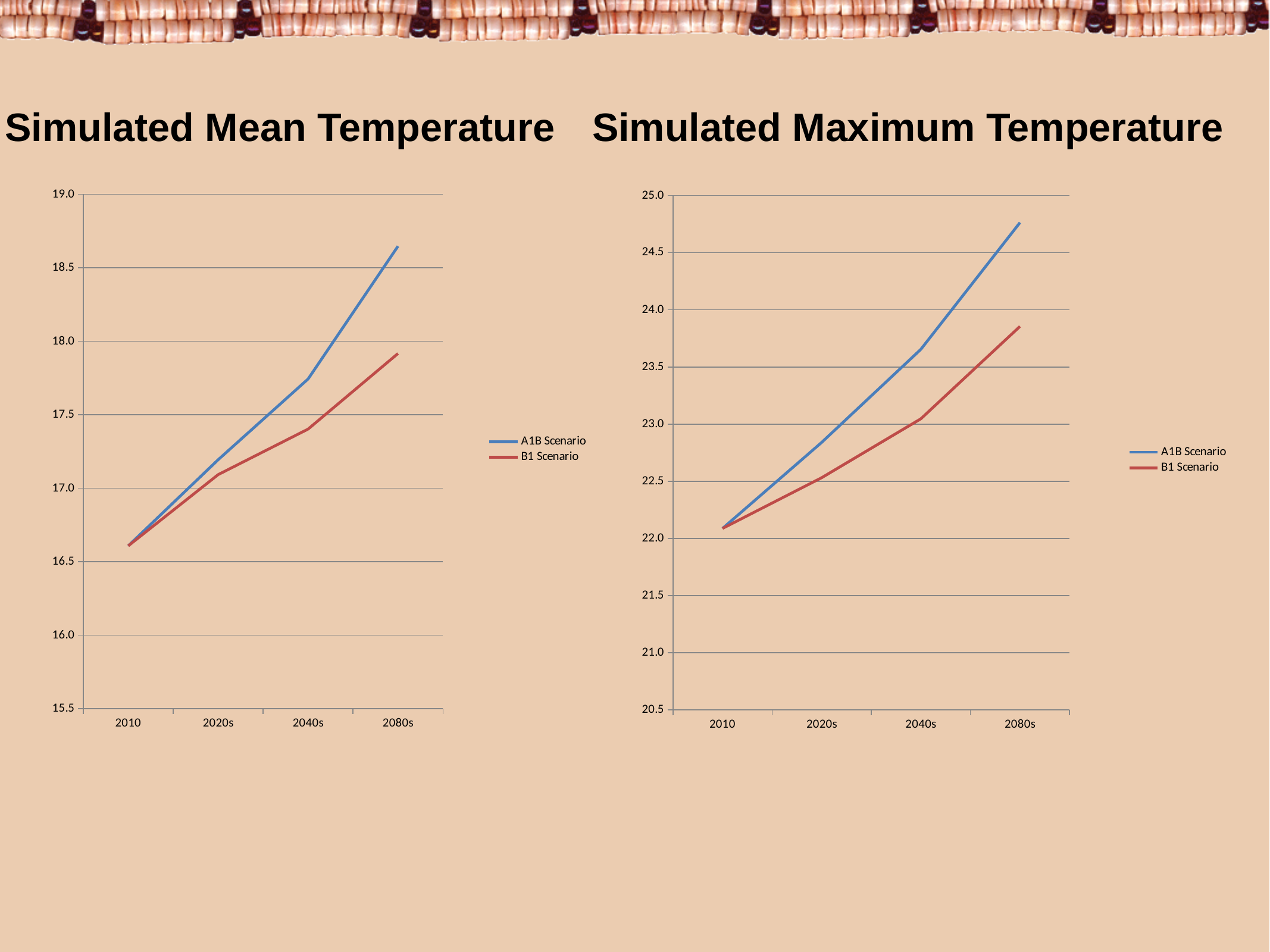
In the Simulated Mean Temperature chart, is the B1 Scenario value for the 2080s greater or less than 18.0? less In the Simulated Maximum Temperature chart, what colour is the line for the B1 Scenario? red In the Simulated Mean Temperature chart, which scenario has the higher value in the 2080s? A1B Scenario In the Simulated Maximum Temperature chart, is the B1 Scenario value for the 2080s greater or less than 24.0? less In the Simulated Maximum Temperature chart, is the A1B Scenario value for the 2080s greater or less than 24.5? greater In the Simulated Maximum Temperature chart, which scenario has the higher value in the 2040s? A1B Scenario What kind of chart is the Simulated Mean Temperature chart? line chart In the Simulated Mean Temperature chart, do the A1B Scenario values rise or fall from 2010 to the 2080s? rise How many points are plotted along the x axis of the Simulated Mean Temperature chart? 4 In the Simulated Maximum Temperature chart, do the B1 Scenario values rise or fall from 2010 to the 2080s? rise How many series does the legend of the Simulated Maximum Temperature chart list? 2